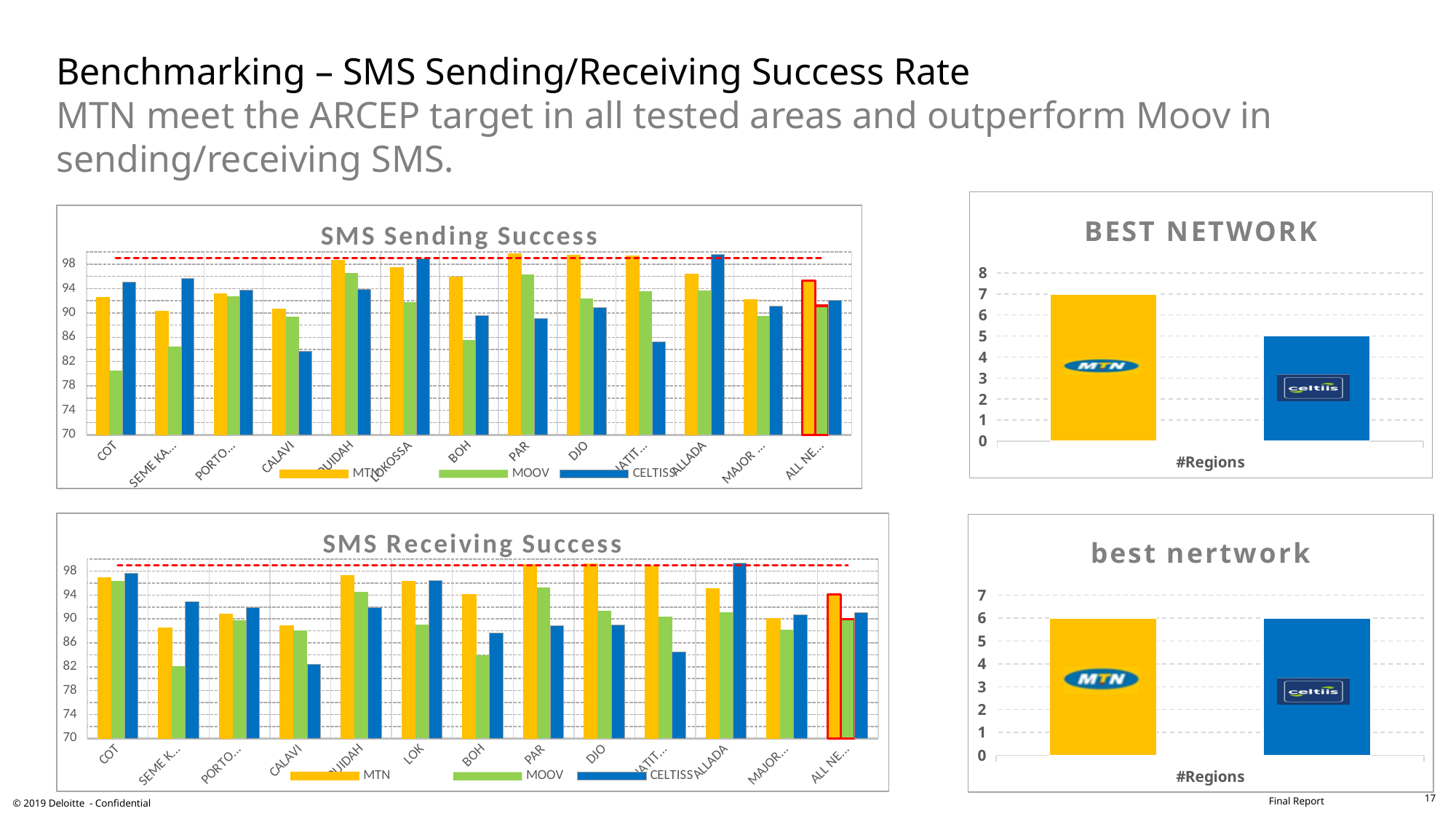
What kind of chart is the SMS Sending Success chart? bar chart In the SMS Receiving Success chart, is the CELTISS value for CALAVI greater or less than 86? less In the BEST NETWORK chart, what is the value of the Celtiis bar? 5 In the SMS Receiving Success chart, how many categories are shown on the x axis? 13 In the bottom-right 'best nertwork' chart, what is the value of the MTN bar? 6 In the BEST NETWORK chart, what is the value of the MTN bar? 7 In the SMS Sending Success chart, is the MOOV value for COT greater or less than 82? less In the SMS Sending Success chart, how many series does the legend list? 3 In the bottom-right 'best nertwork' chart, what is the value of the Celtiis bar? 6 In the BEST NETWORK chart, what is the difference between the MTN and Celtiis bars? 2 In the SMS Sending Success chart, which is larger for COT, the CELTISS value or the MOOV value? CELTISS In the SMS Receiving Success chart, which is larger for CALAVI, the MTN value or the CELTISS value? MTN